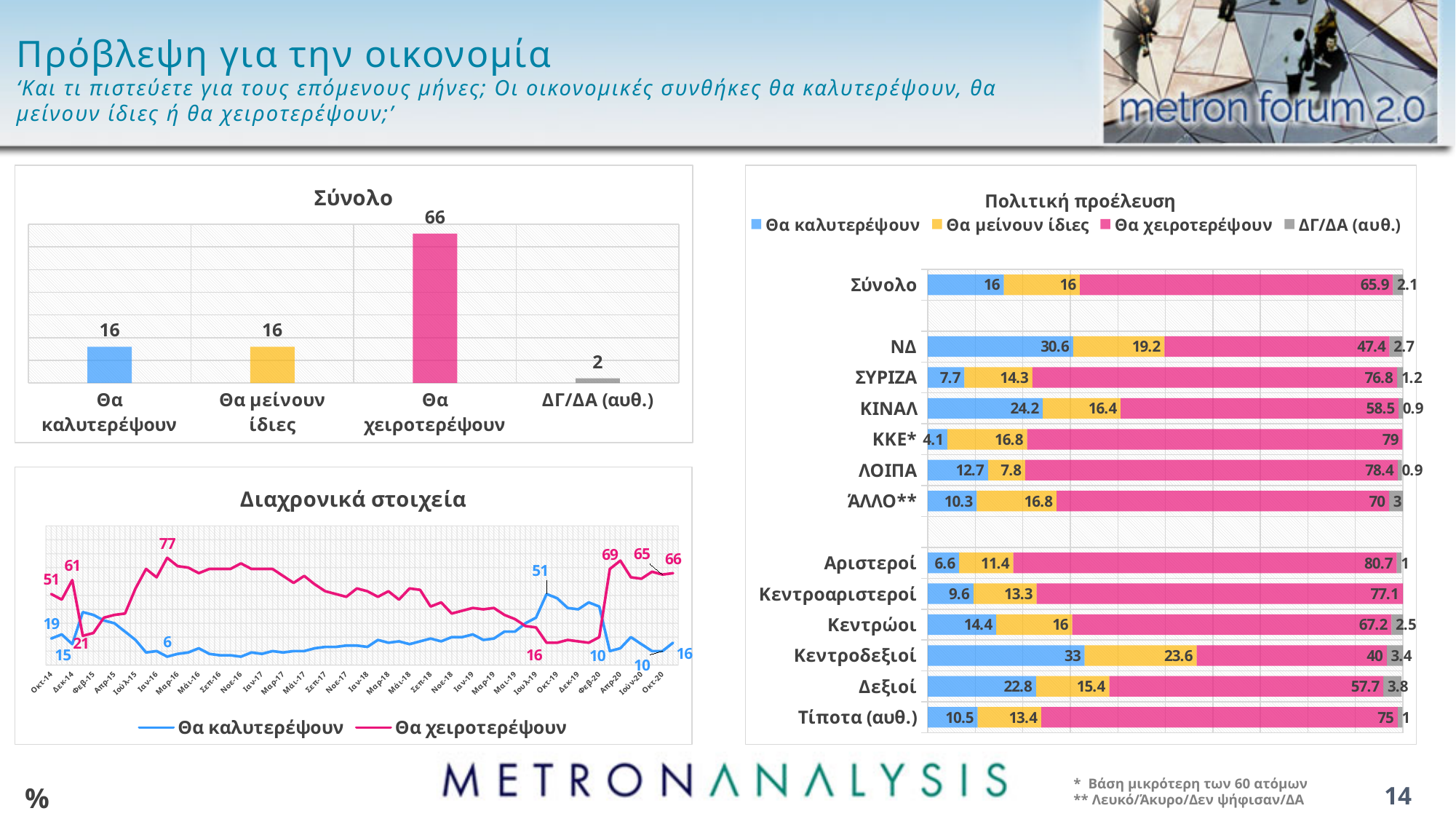
In the 'Σύνολο' chart, what is the difference between 'Θα χειροτερέψουν' and 'Θα καλυτερέψουν'? 50 In the 'Σύνολο' chart, which category has the lowest value? ΔΓ/ΔΑ (αυθ.) In the 'Πολιτική προέλευση' chart, which group has the highest 'Θα καλυτερέψουν' value? Κεντροδεξιοί In the 'Πολιτική προέλευση' chart, which group has the lowest 'Θα χειροτερέψουν' value? Κεντροδεξιοί In the 'Πολιτική προέλευση' chart, is the 'Θα καλυτερέψουν' value for ΝΔ larger or smaller than that for ΚΙΝΑΛ? Larger What kind of chart is 'Διαχρονικά στοιχεία'? Line chart In the 'Διαχρονικά στοιχεία' chart, what is the highest labelled value of the 'Θα χειροτερέψουν' series? 77 In the 'Σύνολο' chart, how many categories are shown? 4 In the 'Πολιτική προέλευση' chart, what is the 'Θα χειροτερέψουν' value for ΣΥΡΙΖΑ? 76.8 In the 'Διαχρονικά στοιχεία' chart, how many series does the legend list? 2 In the 'Σύνολο' chart, what is the value for 'Θα χειροτερέψουν'? 66